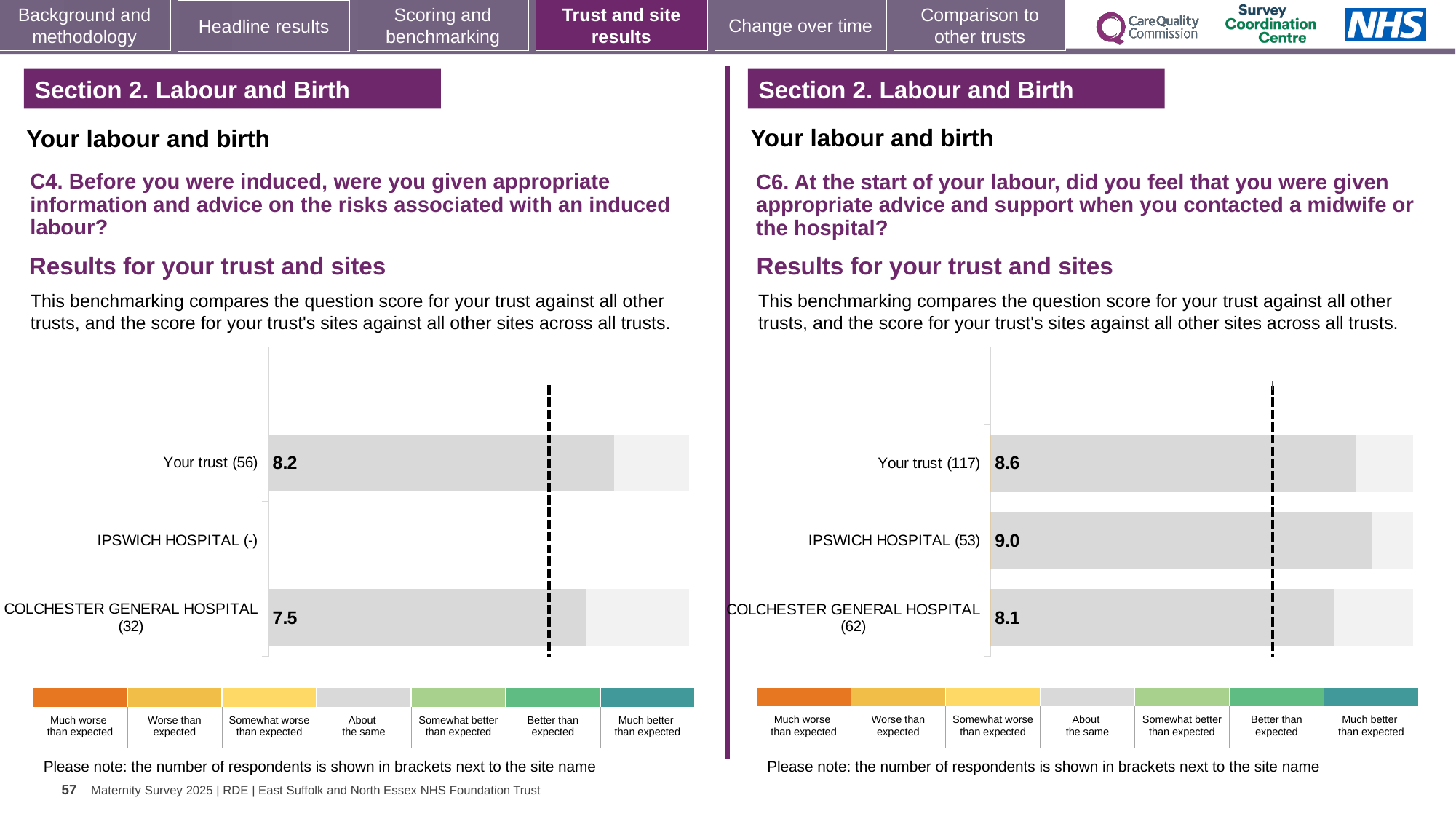
What type of chart is used in the left chart (C4)? Bar chart In the right chart (C6), what is the score for Your trust? 8.6 In the right chart (C6), what is the score for Colchester General Hospital? 8.1 In the right chart (C6), which site or trust has the lowest score? Colchester General Hospital In the left chart (C4), what is the score for Colchester General Hospital? 7.5 How many respondents are shown in brackets for Your trust in the right chart (C6)? 117 In the left chart (C4), what is the difference between the score for Your trust and the score for Colchester General Hospital? 0.7 In the left chart (C4), what is the score for Your trust? 8.2 In the left chart (C4), which has the larger score, Your trust or Colchester General Hospital? Your trust In the right chart (C6), what is the score for Ipswich Hospital? 9.0 In the right chart (C6), which site or trust has the highest score? Ipswich Hospital In the right chart (C6), what is the difference between the score for Ipswich Hospital and the score for Colchester General Hospital? 0.9